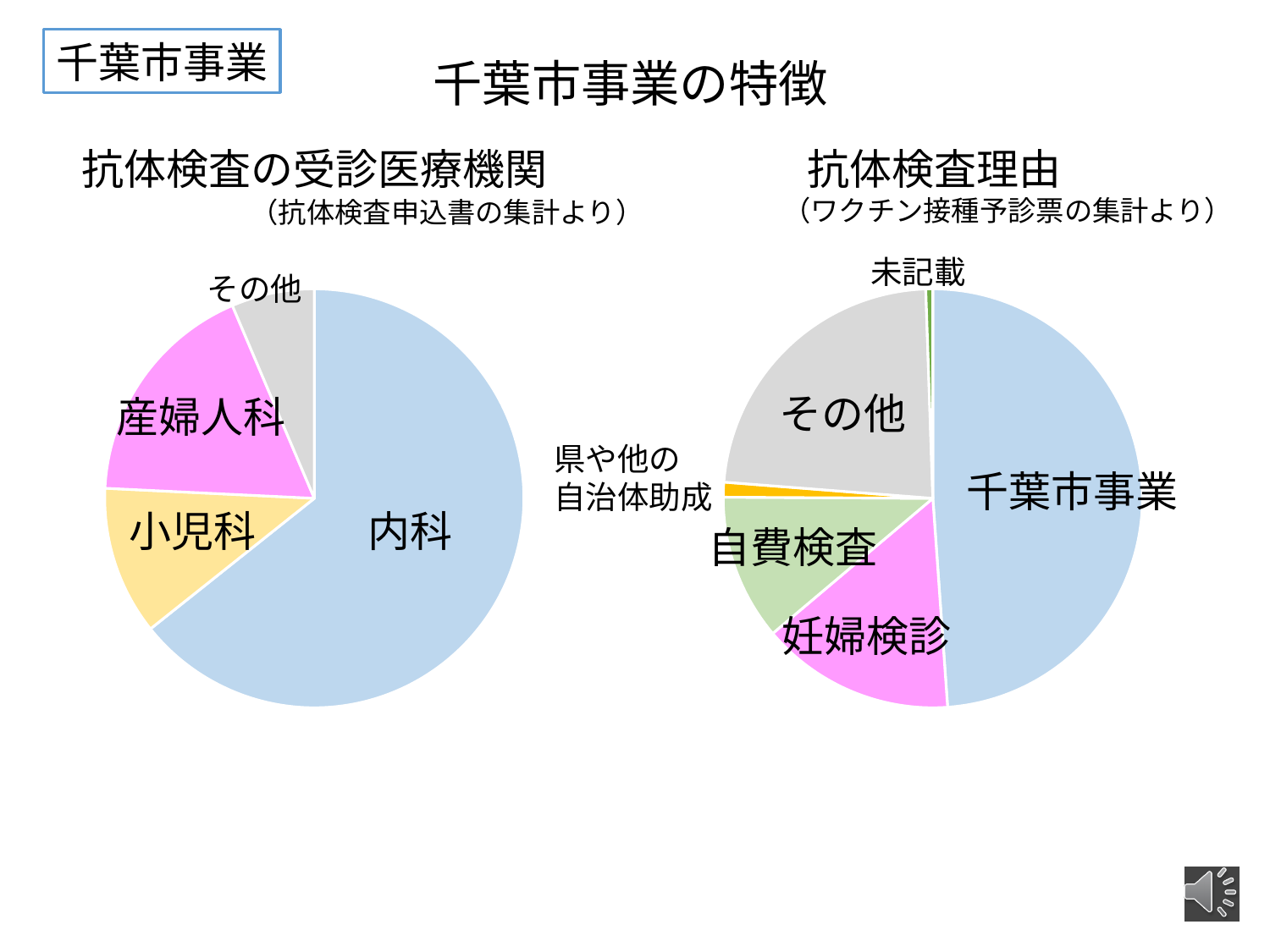
In the left chart (抗体検査の受診医療機関), which category has the smallest slice? その他 In the right chart (抗体検査理由), which category has the largest slice? 千葉市事業 In the right chart (抗体検査理由), how many slices does the pie have? 6 In the right chart (抗体検査理由), which category has the smallest slice? 未記載 In the right chart (抗体検査理由), which slice is larger: 妊婦検診 or 自費検査? 妊婦検診 In the left chart (抗体検査の受診医療機関), how many slices does the pie have? 4 In the left chart (抗体検査の受診医療機関), which category has the largest slice? 内科 What kind of chart is the left chart titled 抗体検査の受診医療機関? pie chart In the left chart (抗体検査の受診医療機関), which slice is larger: 内科 or 産婦人科? 内科 In the right chart (抗体検査理由), which slice is larger: その他 or 妊婦検診? その他 What kind of chart is the right chart titled 抗体検査理由? pie chart According to the subtitle, what source is the right chart (抗体検査理由) compiled from? ワクチン接種予診票の集計